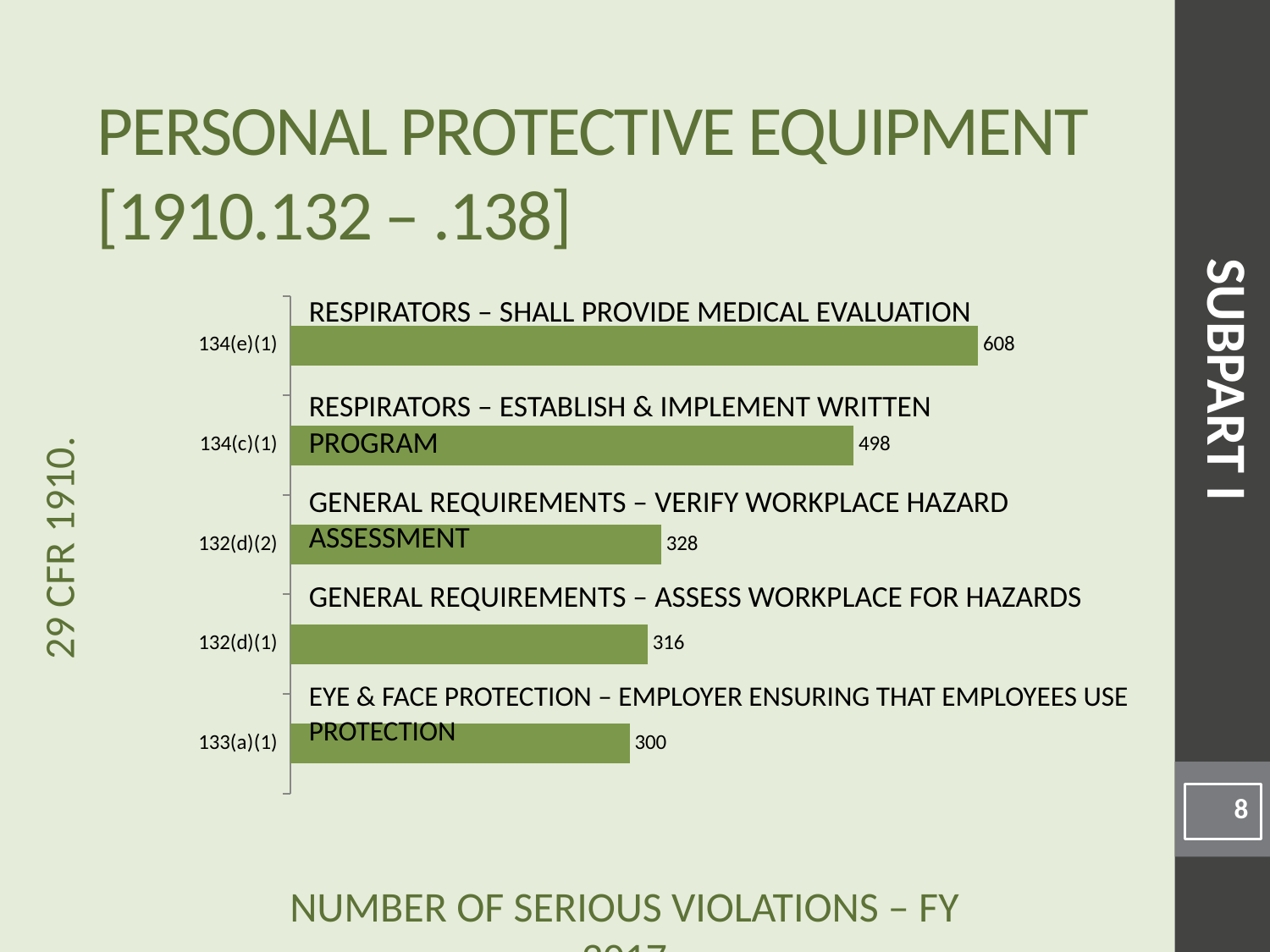
What kind of chart is shown on the slide? Bar chart What is the title of the slide? PERSONAL PROTECTIVE EQUIPMENT [1910.132 – .138] What is the number of serious violations for 134(c)(1)? 498 What is the difference between the values for 134(e)(1) and 134(c)(1)? 110 What is the number of serious violations for 134(e)(1)? 608 Which category has the highest number of serious violations? 134(e)(1) How many categories are shown in the chart? 5 What is the number of serious violations for 132(d)(2)? 328 What is the number of serious violations for 133(a)(1)? 300 Which category has the lowest number of serious violations? 133(a)(1) Which has more serious violations, 132(d)(2) or 132(d)(1)? 132(d)(2) What is the difference between the values for 132(d)(1) and 133(a)(1)? 16